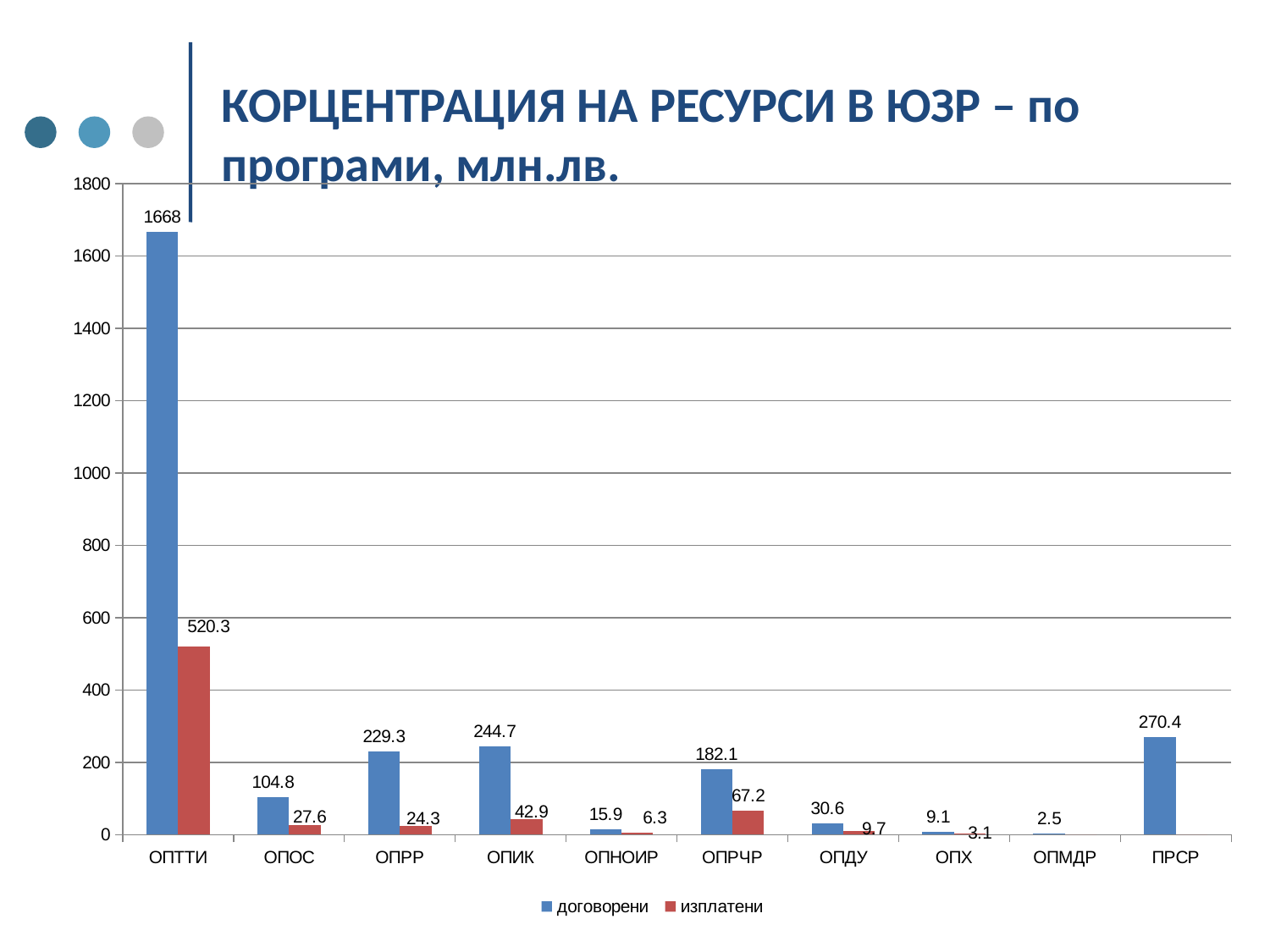
What is the difference between the договорени and изплатени values for ОПТТИ? 1147.7 Is the договорени value for ОПРЧР greater or less than 200? less How many categories are shown on the x axis? 10 Which category has the lowest договорени value? ОПМДР What is the договорени value for ОПТТИ? 1668 What is the изплатени value for ОПРЧР? 67.2 How many series does the legend list? 2 Which is larger, the договорени value for ОПИК or the договорени value for ОПРР? ОПИК What type of chart is shown on the slide? bar chart What is the договорени value for ПРСР? 270.4 Which category has the highest договорени value? ОПТТИ Which series is shown in red? изплатени